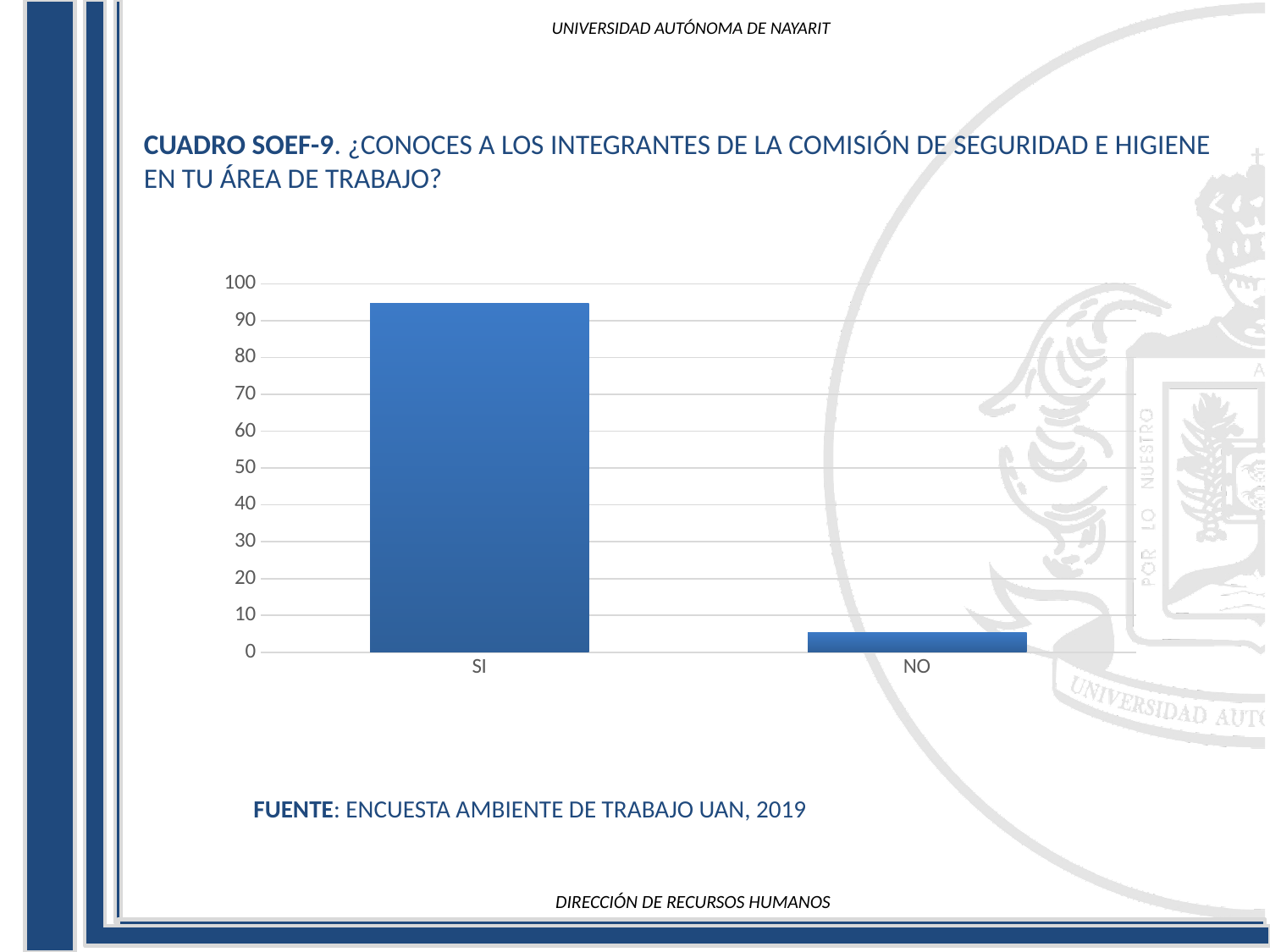
Is the value for SI greater or less than 90? greater What are the labels of the two categories on the x axis? SI and NO Which is larger, the value for SI or the value for NO? SI What kind of chart is shown on the slide? bar chart How many categories are shown on the x axis of the chart? 2 Which category has the lowest value in the chart? NO Which category has the highest value in the chart? SI What is the highest tick value shown on the vertical axis of the chart? 100 Is the value for SI greater or less than 100? less Is the value for NO greater or less than 10? less